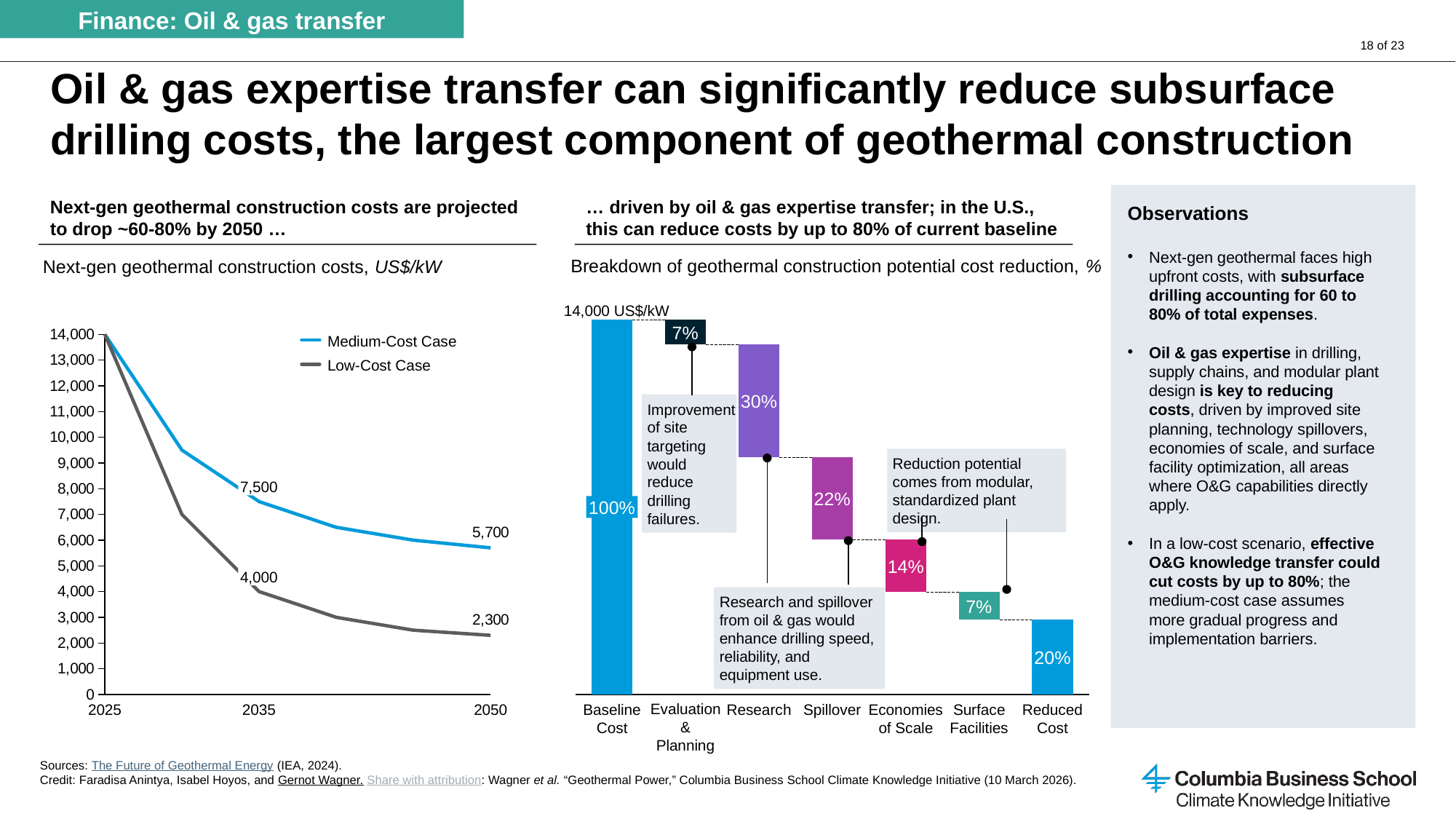
In the left chart (Next-gen geothermal construction costs), how many series does the legend list? 2 In the left chart (Next-gen geothermal construction costs), what is the Medium-Cost Case value labelled in 2050? 5,700 What kind of chart is the left chart (Next-gen geothermal construction costs)? line chart In the right chart (Breakdown of geothermal construction potential cost reduction), what is the value for Reduced Cost? 20% In the left chart (Next-gen geothermal construction costs), what is the Medium-Cost Case value labelled in 2035? 7,500 In the right chart (Breakdown of geothermal construction potential cost reduction), how many categories are shown on the x axis? 7 In the right chart (Breakdown of geothermal construction potential cost reduction), which is larger, Spillover or Economies of Scale? Spillover In the left chart (Next-gen geothermal construction costs), what is the difference between the Medium-Cost Case and Low-Cost Case values in 2050? 3,400 In the right chart (Breakdown of geothermal construction potential cost reduction), which reduction category has the highest value? Research In the left chart (Next-gen geothermal construction costs), what is the Low-Cost Case value labelled in 2050? 2,300 In the right chart (Breakdown of geothermal construction potential cost reduction), what is the value for Research? 30% In the left chart (Next-gen geothermal construction costs), do the values rise or fall from 2025 to 2050? fall